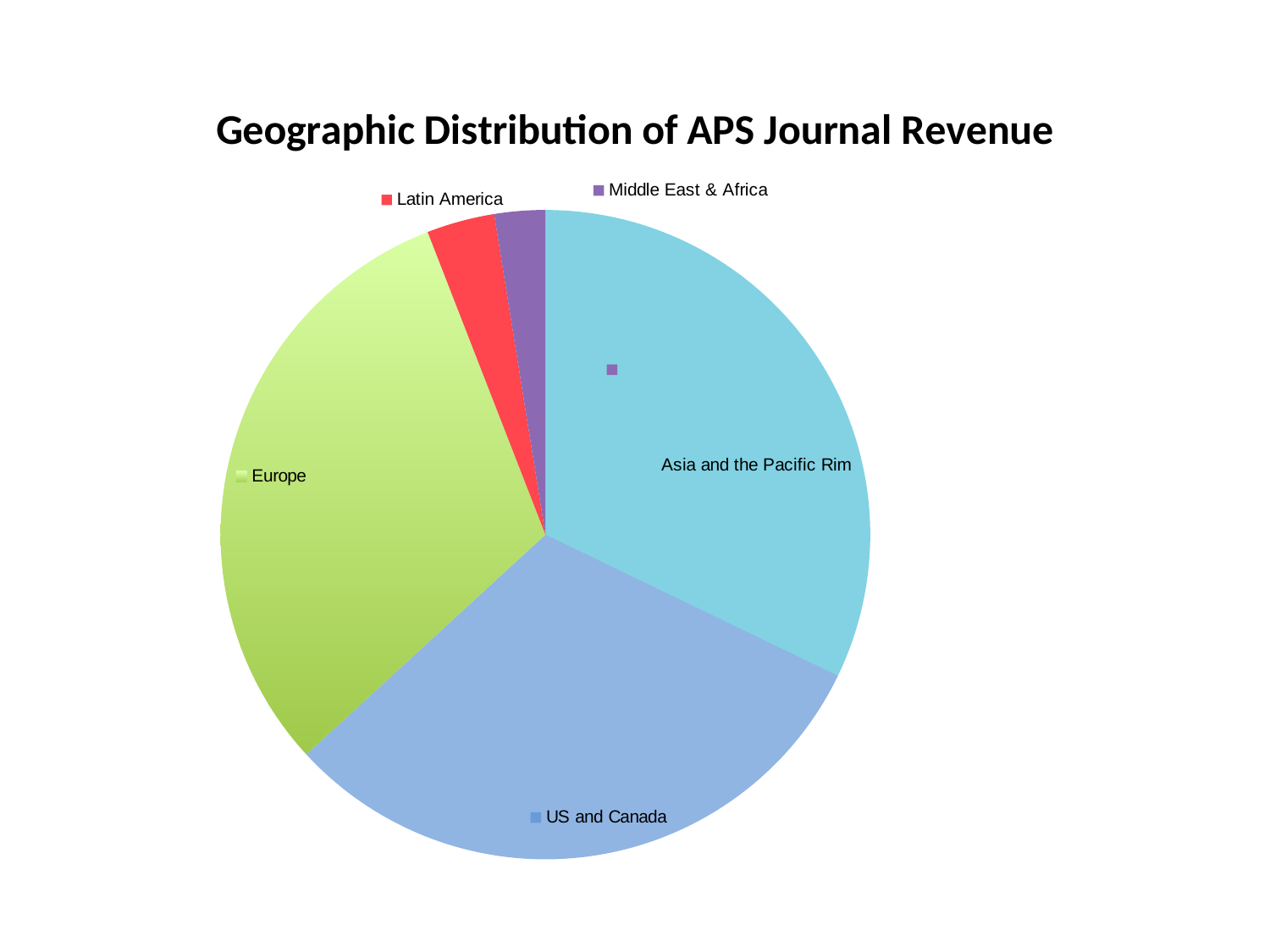
Which slice is larger, Asia and the Pacific Rim or Latin America? Asia and the Pacific Rim Which slice is smaller, Middle East & Africa or Europe? Middle East & Africa What is the title of the chart? Geographic Distribution of APS Journal Revenue What colour is the Latin America slice? Red What kind of chart is shown on the slide? Pie chart How many slices does the pie chart have? 5 Which slice is larger, US and Canada or Middle East & Africa? US and Canada